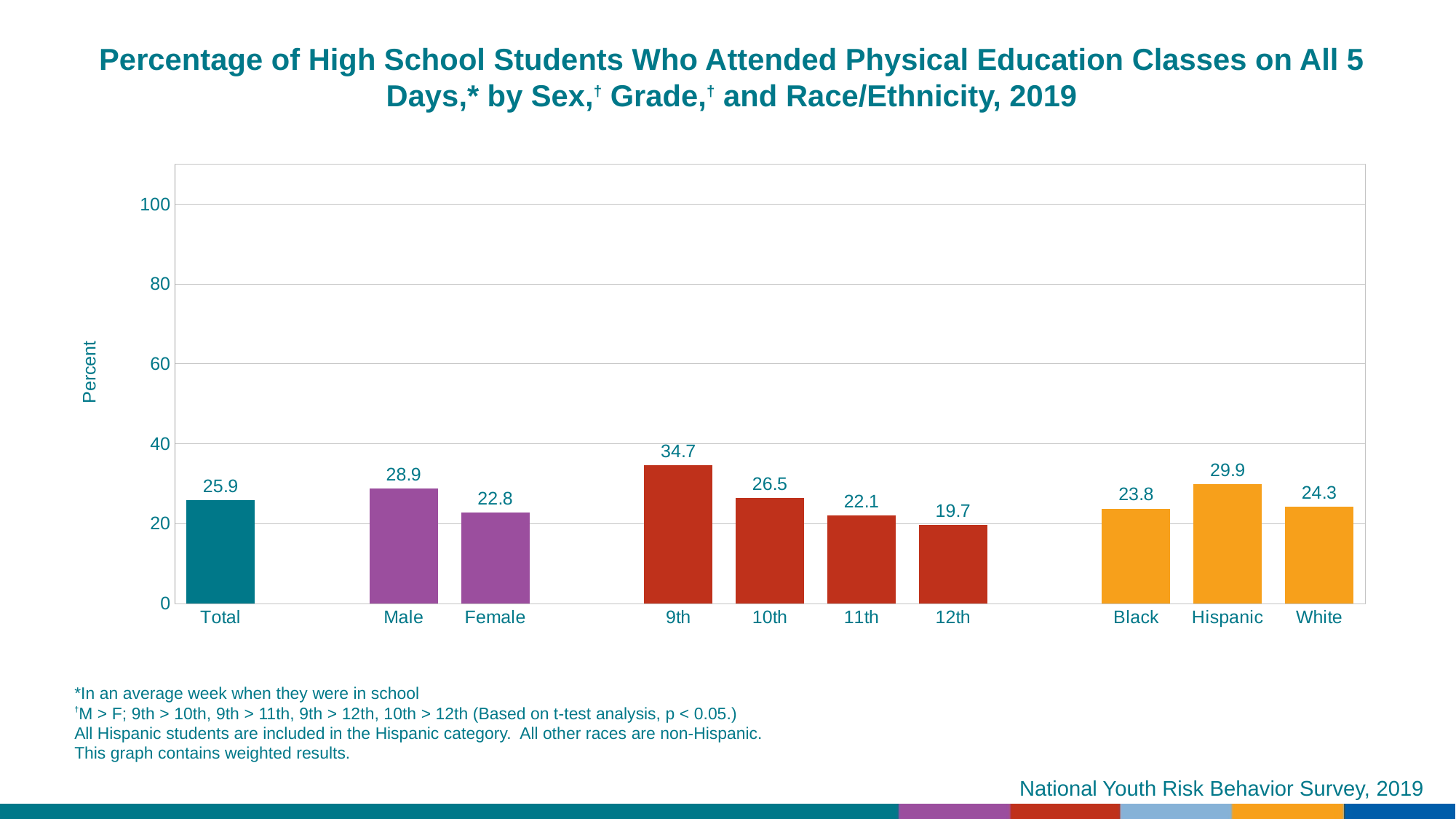
What is the value for Total? 25.9 What is the difference between the values for 9th and 12th? 15 Which category has the lowest value? 12th What is the label of the y axis? Percent What is the value for Hispanic? 29.9 What kind of chart is shown on the slide? bar chart Which category has the highest value? 9th What is the value for Female? 22.8 How many categories are shown on the x axis? 10 Which is larger, the value for Black or the value for White? White What is the difference between the values for Male and Female? 6.1 Is the value for 9th greater or less than 40? less